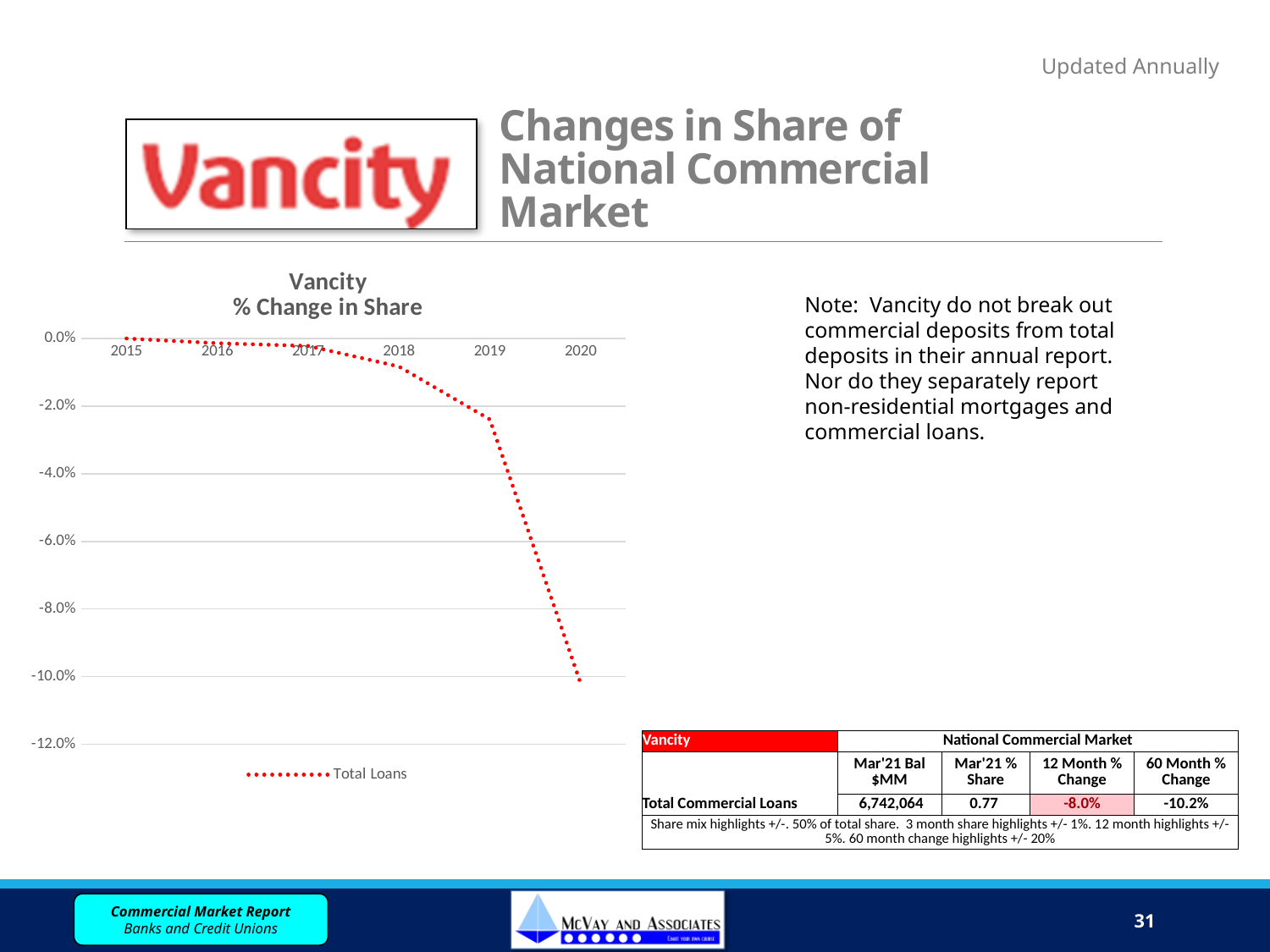
Is the Total Loans value for 2020 greater or less than -8.0%? less What series name appears in the chart legend? Total Loans What is the title of the chart? Vancity % Change in Share Is the Total Loans value for 2019 greater or less than -4.0%? greater Which is larger, the Total Loans value for 2019 or for 2020? 2019 How many years are labelled on the x axis of the chart? 6 What kind of chart is shown on the slide? line chart Is the Total Loans value for 2018 greater or less than -2.0%? greater Which is larger, the Total Loans value for 2017 or for 2020? 2017 Which year has the lowest Total Loans % change in share? 2020 How many series does the chart legend list? 1 Do the Total Loans values rise or fall from 2015 to 2020? fall